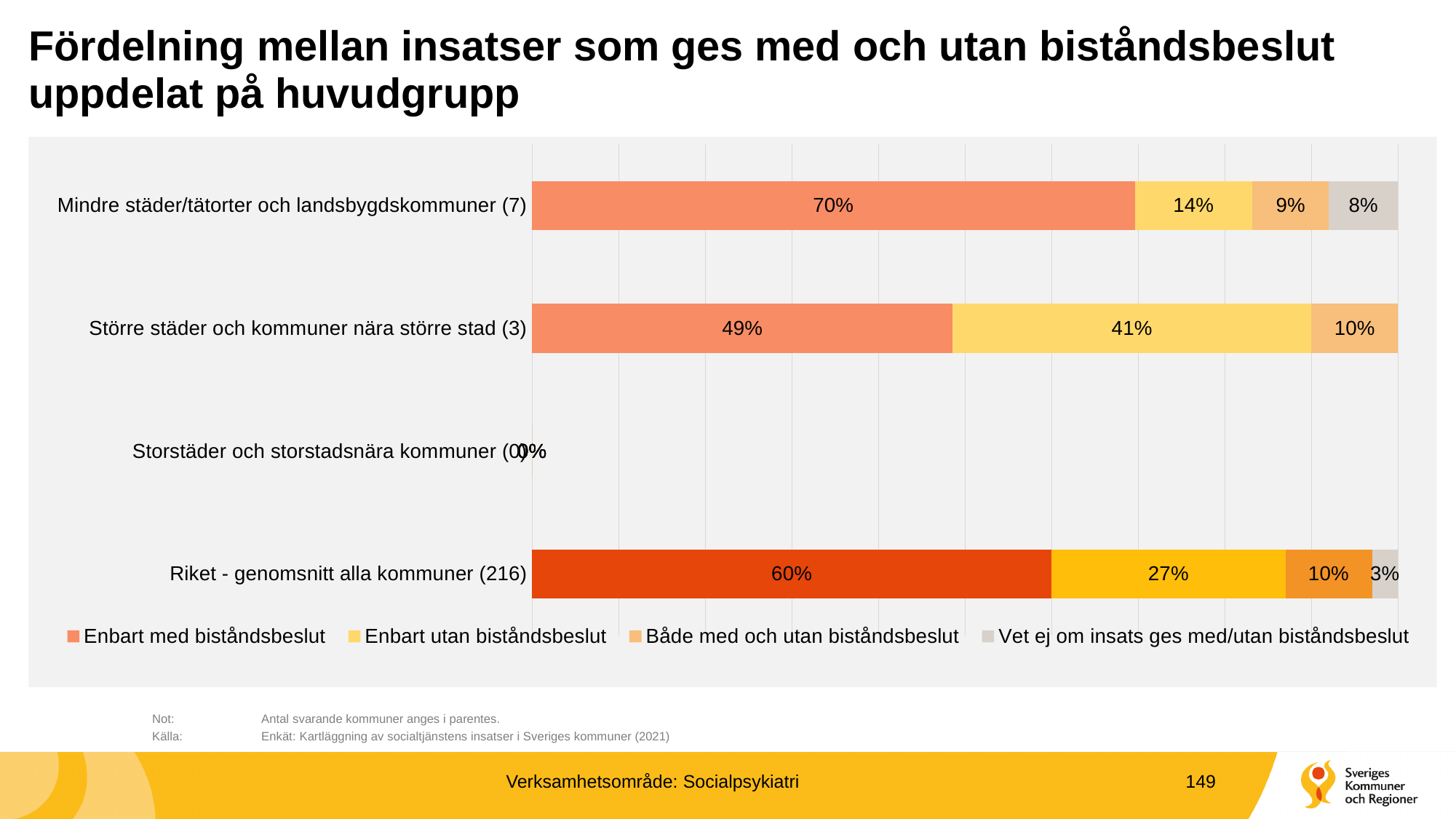
What is the value of 'Vet ej om insats ges med/utan biståndsbeslut' for 'Mindre städer/tätorter och landsbygdskommuner (7)'? 8% How many categories are shown on the vertical axis? 4 What is the value of 'Enbart utan biståndsbeslut' for 'Större städer och kommuner nära större stad (3)'? 41% Which is larger: 'Enbart utan biståndsbeslut' for 'Riket - genomsnitt alla kommuner (216)' or for 'Mindre städer/tätorter och landsbygdskommuner (7)'? Riket - genomsnitt alla kommuner (216) What is the difference between the 'Enbart med biståndsbeslut' values for 'Mindre städer/tätorter och landsbygdskommuner (7)' and 'Riket - genomsnitt alla kommuner (216)'? 10% What is the value of 'Enbart med biståndsbeslut' for 'Mindre städer/tätorter och landsbygdskommuner (7)'? 70% How many series does the legend list? 4 What is the total of the stacked bar for 'Riket - genomsnitt alla kommuner (216)'? 100% What is the value of 'Både med och utan biståndsbeslut' for 'Riket - genomsnitt alla kommuner (216)'? 10% Which category has the highest value for 'Enbart utan biståndsbeslut'? Större städer och kommuner nära större stad (3) What kind of chart is shown on the slide? Stacked bar chart Which category has the highest value for 'Enbart med biståndsbeslut'? Mindre städer/tätorter och landsbygdskommuner (7)